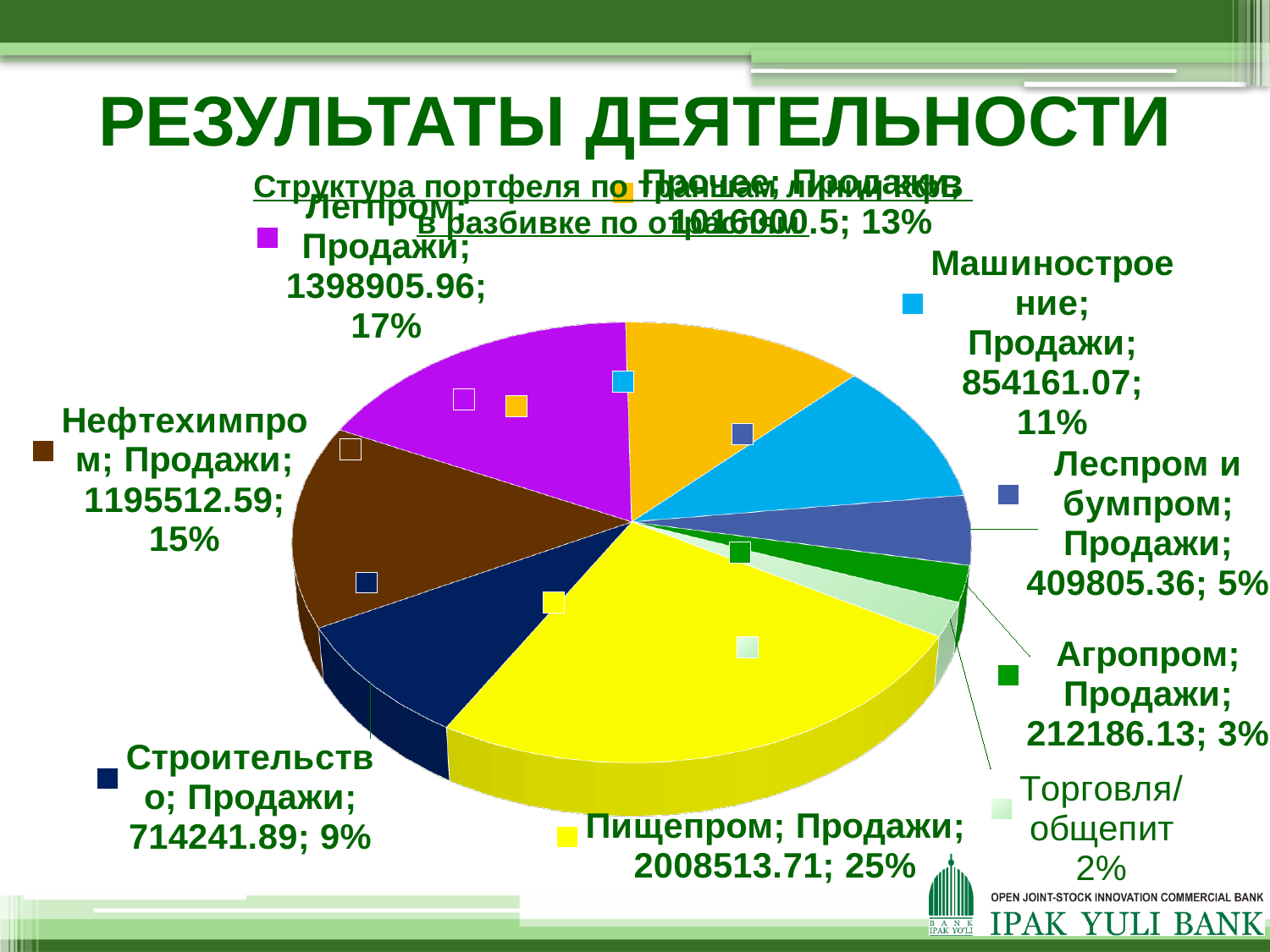
By how many percentage points does the share of Легпром exceed the share of Нефтехимпром? 2 percentage points What share of the pie does Леспром и бумпром account for? 5% What is the sales value shown for Легпром? 1398905.96 How many sectors are shown in the pie chart? 9 Which is larger, the slice for Нефтехимпром or the slice for Машиностроение? Нефтехимпром Which sector has the largest slice of the pie? Пищепром What share of the pie does Пищепром account for? 25% What is the difference between the sales values of Пищепром and Строительство? 1294271.82 Which sector has the smallest slice of the pie? Торговля/общепит What share of the pie does Строительство account for? 9% What kind of chart is shown on the slide? pie chart What is the sales value shown for Агропром? 212186.13